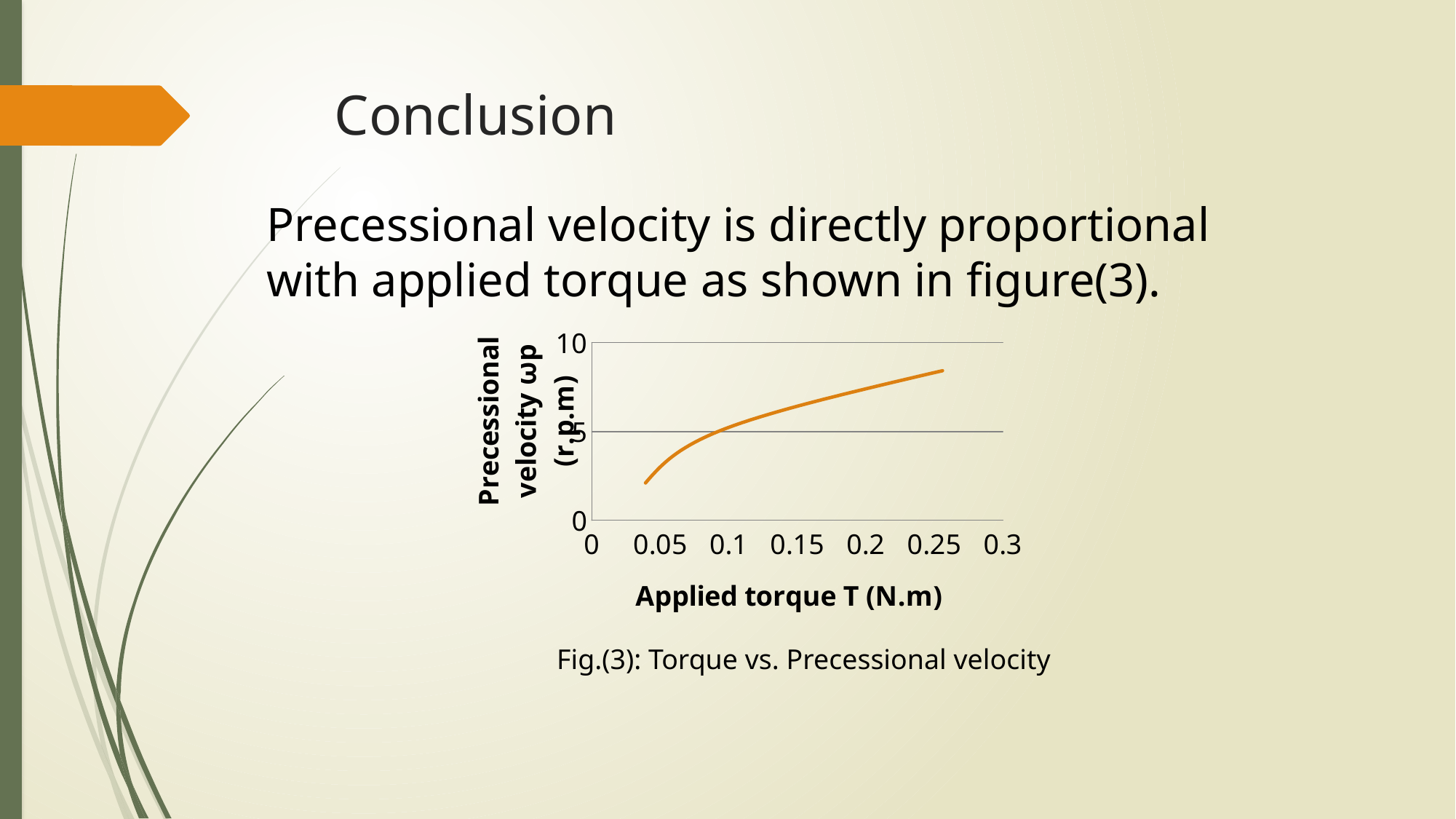
Does the precessional velocity rise or fall as the applied torque increases along the x axis? rise Is the precessional velocity at an applied torque of 0.15 N.m greater or less than 5? greater Is the precessional velocity at an applied torque of 0.2 N.m greater or less than 5? greater What is the label of the x axis of the chart? Applied torque T (N.m) Is the precessional velocity at an applied torque of 0.25 N.m greater or less than 10? less What is the highest value shown on the y axis of the chart? 10 Which is larger, the precessional velocity at 0.05 N.m or at 0.25 N.m? 0.25 N.m What is the caption given below the chart? Fig.(3): Torque vs. Precessional velocity What kind of chart is shown in Fig.(3)? line chart What is the highest value shown on the x axis of the chart? 0.3